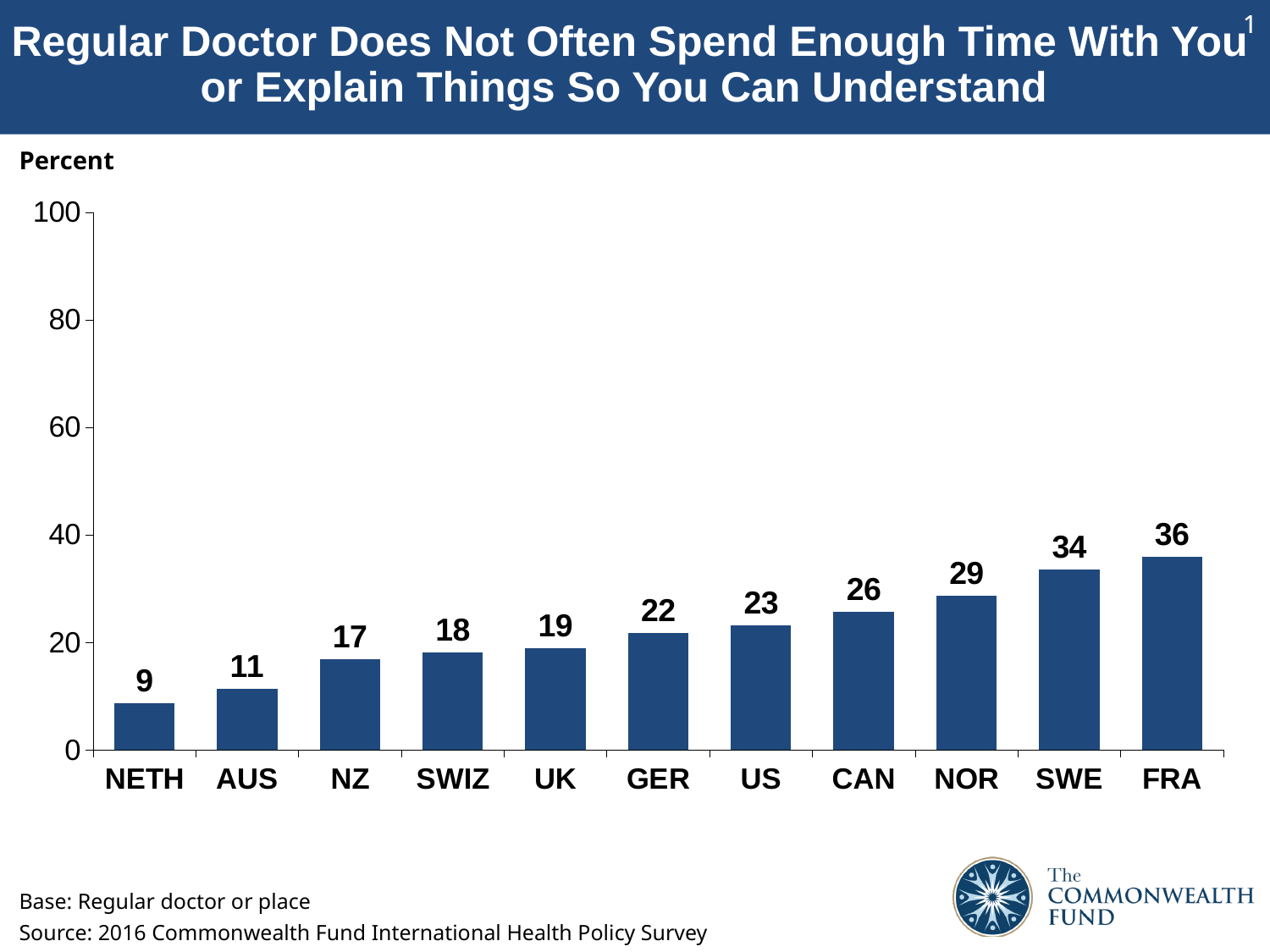
What is the difference between the values for FRA and NETH? 27 What is the value for the US? 23 Which is larger, the value for GER or the value for AUS? GER What is the difference between the values for NOR and CAN? 3 Which country has the lowest value? NETH What is the value for NETH? 9 Is the value for SWE greater or less than 20? greater How many countries are shown on the x axis? 11 Which country has the highest value? FRA What is the value for SWE? 34 What kind of chart is shown on the slide? Bar chart Do the values rise or fall from left to right along the x axis? Rise